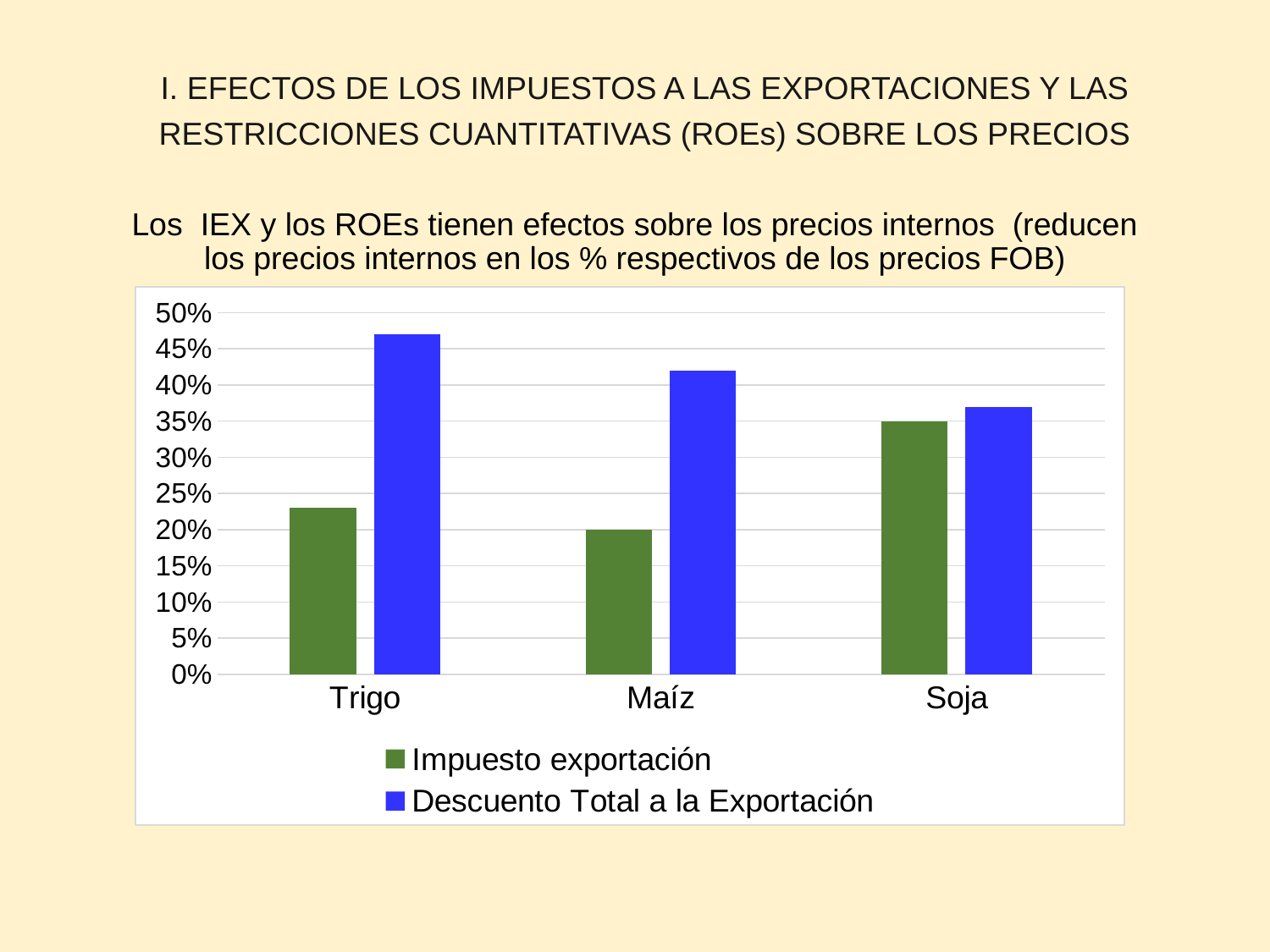
How many series does the chart's legend list? 2 How many categories are shown on the x axis of the chart? 3 Is the Descuento Total a la Exportación value for Trigo greater or less than 45%? greater Which is larger: the Descuento Total a la Exportación value for Trigo or for Maíz? Trigo Which colour represents the Impuesto exportación series in the chart? Green Which category has the lowest value for Impuesto exportación? Maíz Is the Impuesto exportación value for Trigo greater or less than 25%? less Is the Descuento Total a la Exportación value for Soja greater or less than 40%? less Which category has the highest value for Impuesto exportación? Soja Which category has the highest value for Descuento Total a la Exportación? Trigo What kind of chart is shown on the slide? Bar chart